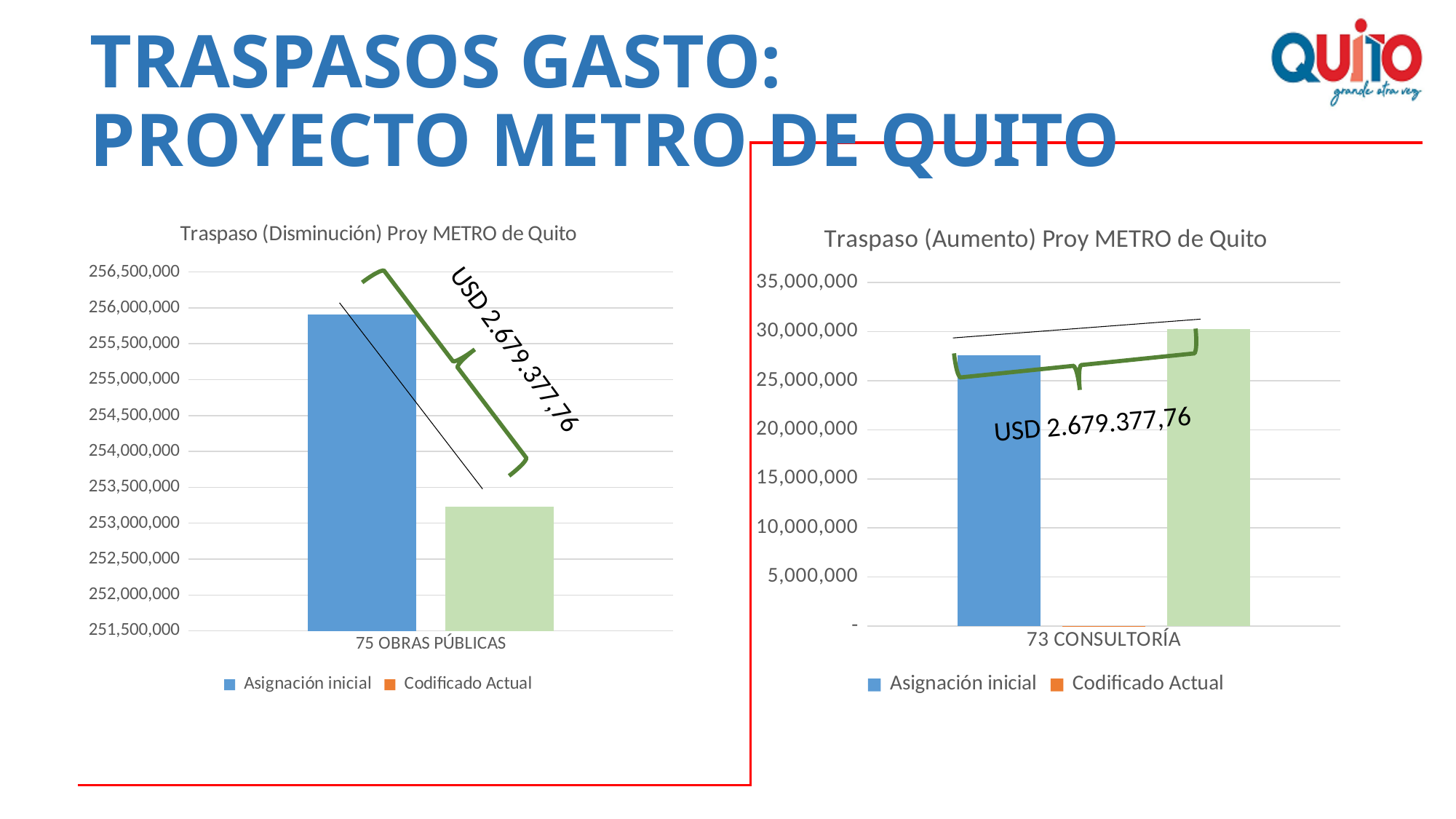
In the right chart, 'Traspaso (Aumento) Proy METRO de Quito', is the value of the Asignación inicial bar for 73 CONSULTORÍA greater or less than 25,000,000? greater In the right chart, 'Traspaso (Aumento) Proy METRO de Quito', is the value of the Asignación inicial bar for 73 CONSULTORÍA greater or less than 30,000,000? less In the left chart, 'Traspaso (Disminución) Proy METRO de Quito', is the value of the Asignación inicial bar for 75 OBRAS PÚBLICAS greater or less than 255,500,000? greater In the right chart, 'Traspaso (Aumento) Proy METRO de Quito', which bar is taller, the blue bar or the green bar? the green bar In the left chart, 'Traspaso (Disminución) Proy METRO de Quito', how many series does the legend list? 2 In the right chart, 'Traspaso (Aumento) Proy METRO de Quito', how many series does the legend list? 2 In the left chart, 'Traspaso (Disminución) Proy METRO de Quito', how many categories are shown on the x axis? 1 What is the category label on the x axis of the right chart, 'Traspaso (Aumento) Proy METRO de Quito'? 73 CONSULTORÍA In the left chart, 'Traspaso (Disminución) Proy METRO de Quito', what amount is written in the annotation next to the bracket? USD 2.679.377,76 What kind of chart is the left chart, 'Traspaso (Disminución) Proy METRO de Quito'? bar chart In the left chart, 'Traspaso (Disminución) Proy METRO de Quito', which bar is taller, the blue bar or the green bar? the blue bar